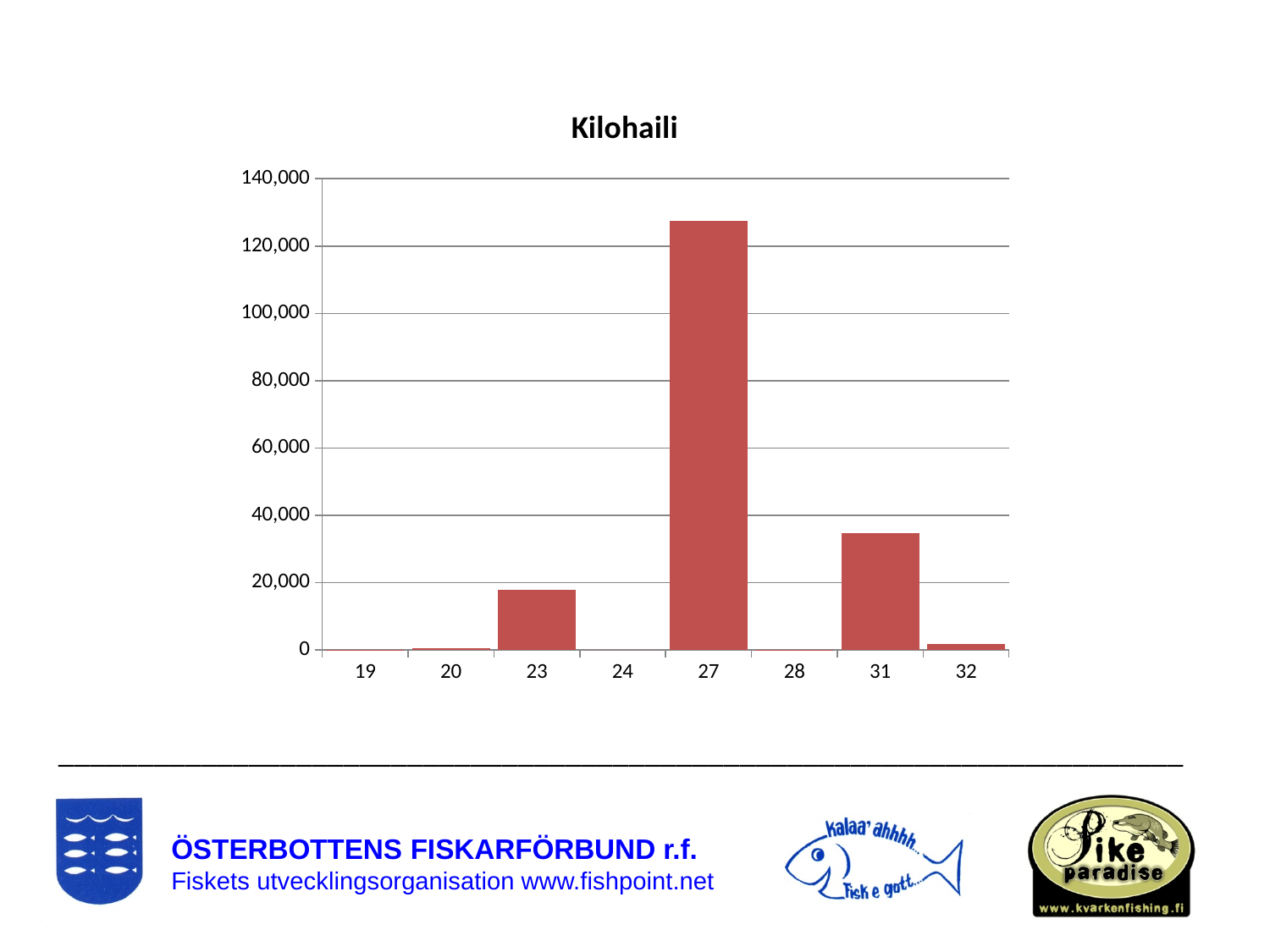
What is the title of the chart? Kilohaili Which has the larger value, category 32 or category 23? 23 Which has the larger value, category 23 or category 31? 31 What type of chart is shown on the slide? bar chart Is the value for category 31 greater or less than 20,000? greater Is the value for category 31 greater or less than 40,000? less Is the value for category 27 greater or less than 120,000? greater Which category has the highest value in the chart? 27 What is the highest value shown on the y axis of the chart? 140,000 Which has the larger value, category 27 or category 31? 27 How many categories are shown on the x axis of the chart? 8